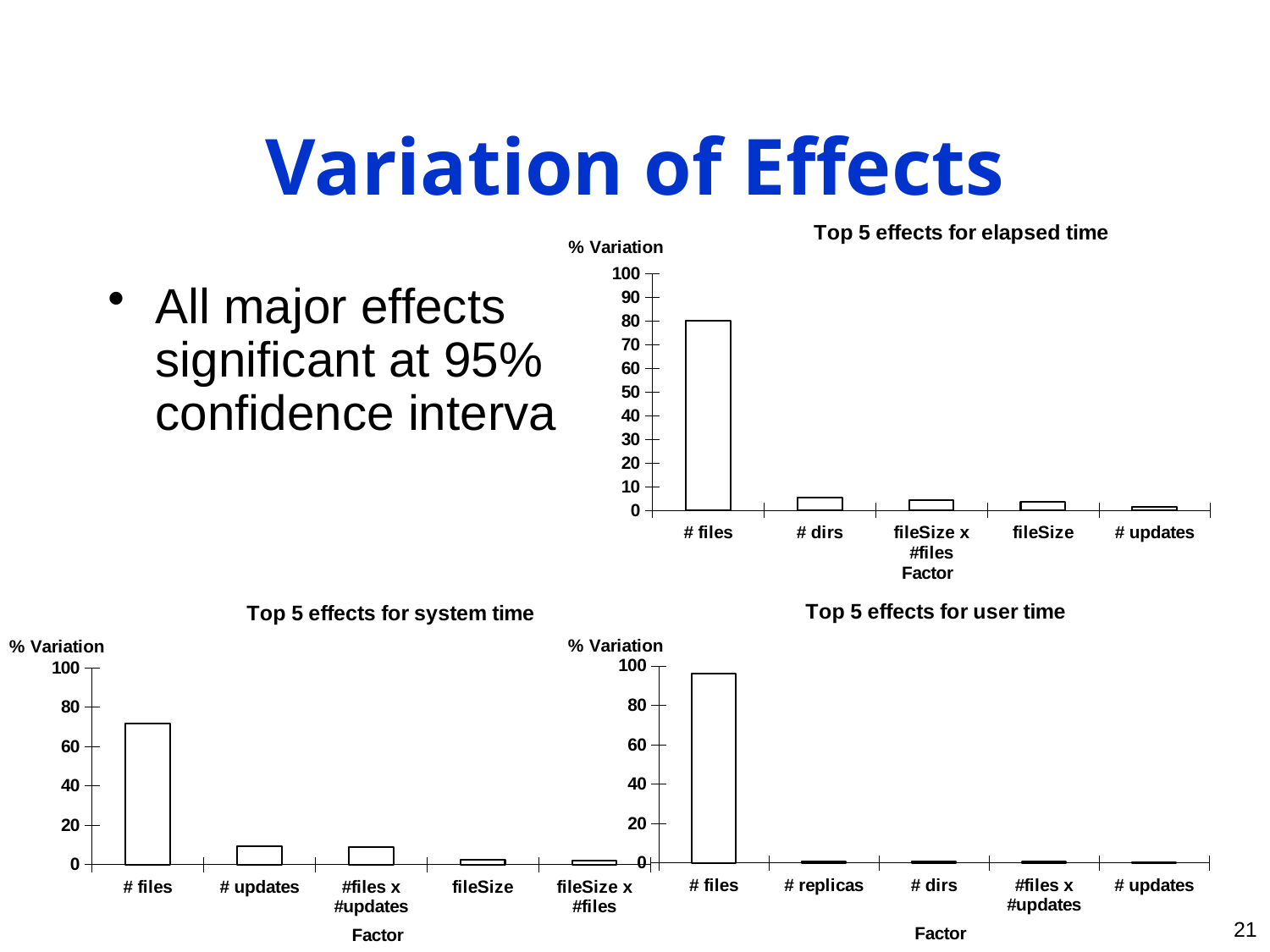
What is the x-axis label of the 'Top 5 effects for user time' chart? Factor In the 'Top 5 effects for system time' chart, is the value for # files greater or less than 60? greater How many factors are shown in the 'Top 5 effects for system time' chart? 5 In the 'Top 5 effects for elapsed time' chart, which factor has the lowest % variation? # updates In the 'Top 5 effects for system time' chart, which factor has the highest % variation? # files In the 'Top 5 effects for elapsed time' chart, which factor has the highest % variation? # files In the 'Top 5 effects for elapsed time' chart, is the value for # dirs greater or less than 10? less In the 'Top 5 effects for elapsed time' chart, is the value for # files greater or less than 70? greater In the 'Top 5 effects for user time' chart, which factor has the highest % variation? # files In the 'Top 5 effects for system time' chart, which is larger, the value for # updates or the value for fileSize? # updates What kind of chart is 'Top 5 effects for elapsed time'? bar chart